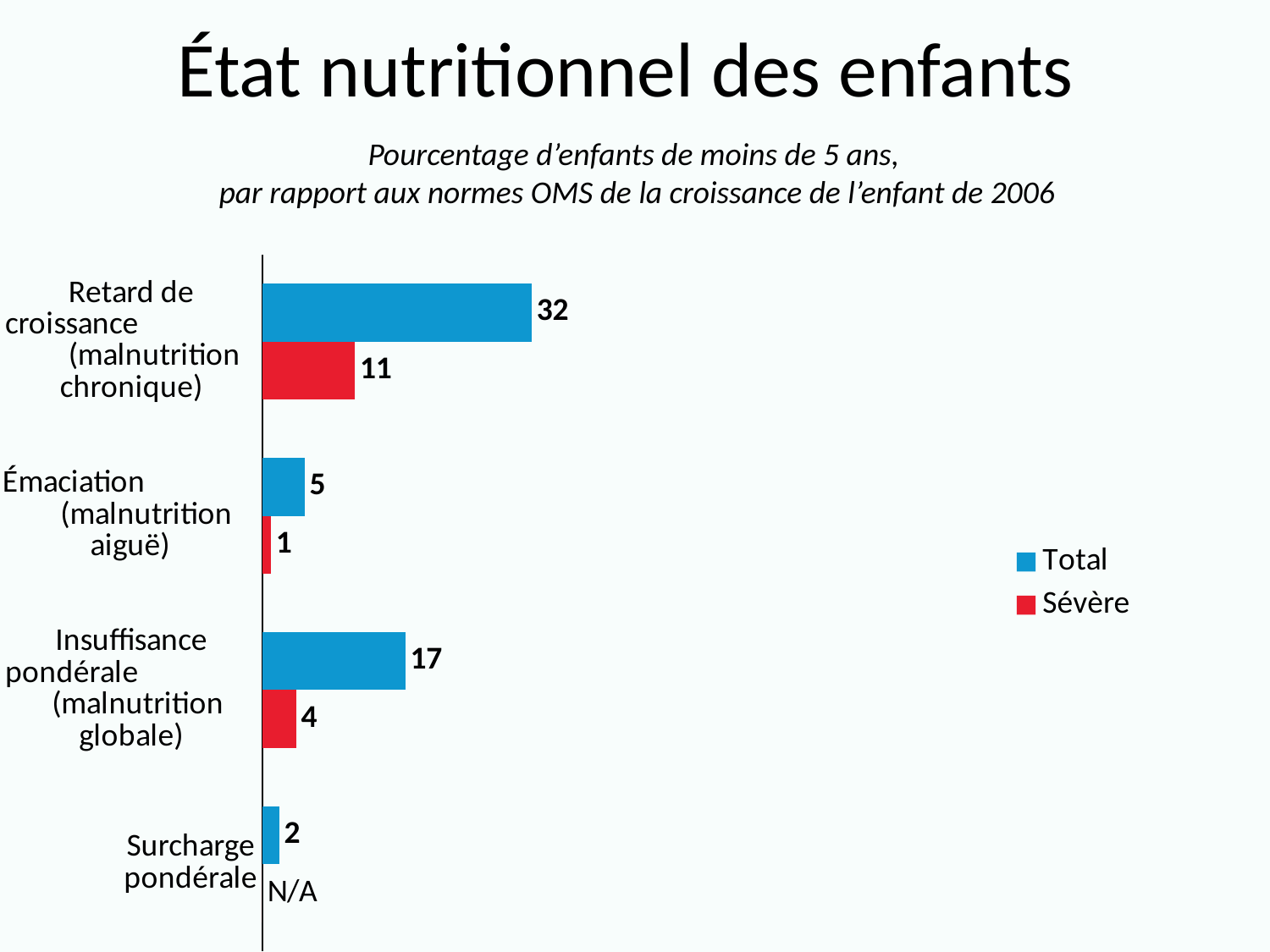
How many series does the legend list? 2 What is shown for the Sévère series for Surcharge pondérale? N/A Which category has the highest Total value? Retard de croissance (malnutrition chronique) Which is larger: the Total value for Insuffisance pondérale or the Total value for Émaciation? Insuffisance pondérale What is the Sévère value for Retard de croissance (malnutrition chronique)? 11 What is the Total value for Retard de croissance (malnutrition chronique)? 32 Which category has the lowest Total value? Surcharge pondérale What is the difference between the Total and Sévère values for Retard de croissance? 21 What is the Total value for Émaciation (malnutrition aiguë)? 5 How many categories are shown on the chart? 4 What is the Sévère value for Insuffisance pondérale (malnutrition globale)? 4 What kind of chart is shown on the slide? Bar chart